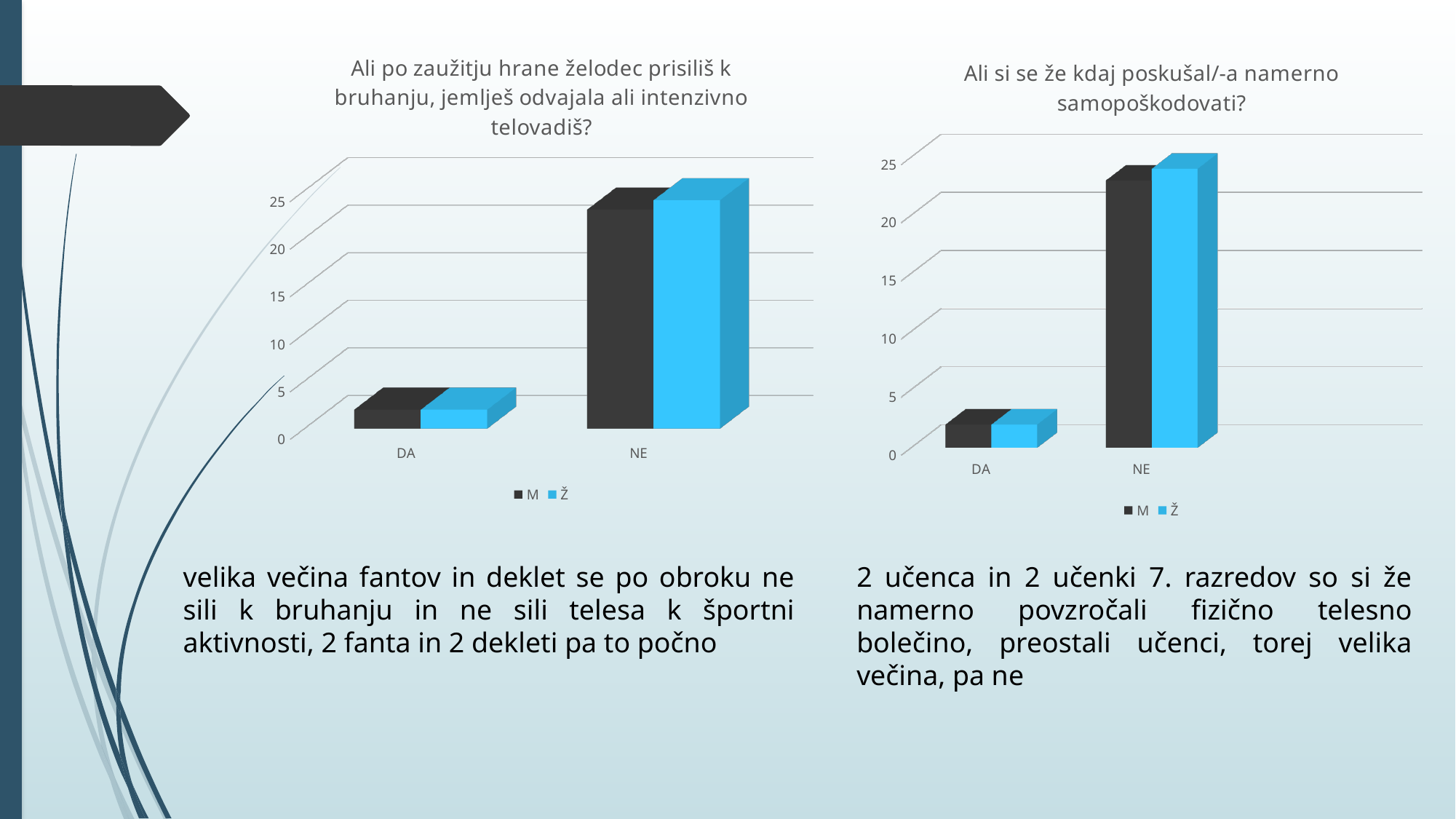
In the right chart, is the value for Ž at NE greater or less than 20? greater In the left chart, how many categories are shown on the x axis? 2 In the right chart, how many series does the legend list? 2 In the right chart, which category has the lowest bars, DA or NE? DA In the left chart, is the value for M at NE greater or less than 20? greater What kind of chart is the right chart titled "Ali si se že kdaj poskušal/-a namerno samopoškodovati?"? bar chart In the left chart, what are the two legend entries? M and Ž In the right chart, which is larger, the value for M at DA or the value for M at NE? M at NE In the right chart, is the value for M at DA greater or less than 5? less In the left chart, which category has the highest bars, DA or NE? NE What kind of chart is the left chart titled "Ali po zaužitju hrane želodec prisiliš k bruhanju, jemlješ odvajala ali intenzivno telovadiš?"? bar chart